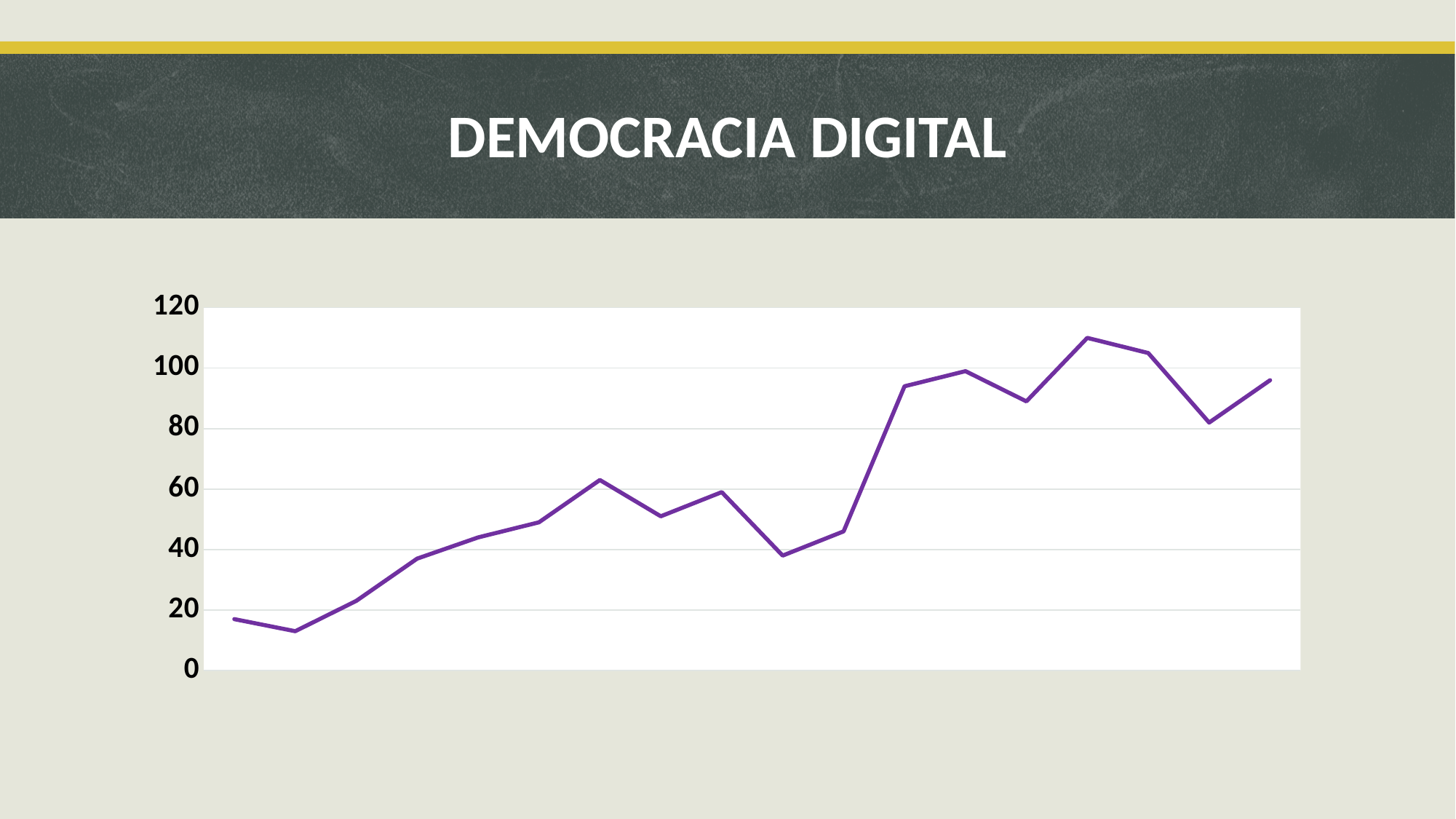
What is the highest value shown on the vertical axis? 120 Is the value of the first point on the line greater or less than 40? less Which is larger, the value of the first point or the value of the last point on the line? the last point Is the lowest point on the line greater or less than 20? less Is the value of the last point on the line greater or less than 80? greater How many data points are plotted on the line? 18 Overall, do the values rise or fall from left to right along the x axis? rise What is the title shown on the slide above the chart? DEMOCRACIA DIGITAL What kind of chart is shown on the slide? line chart